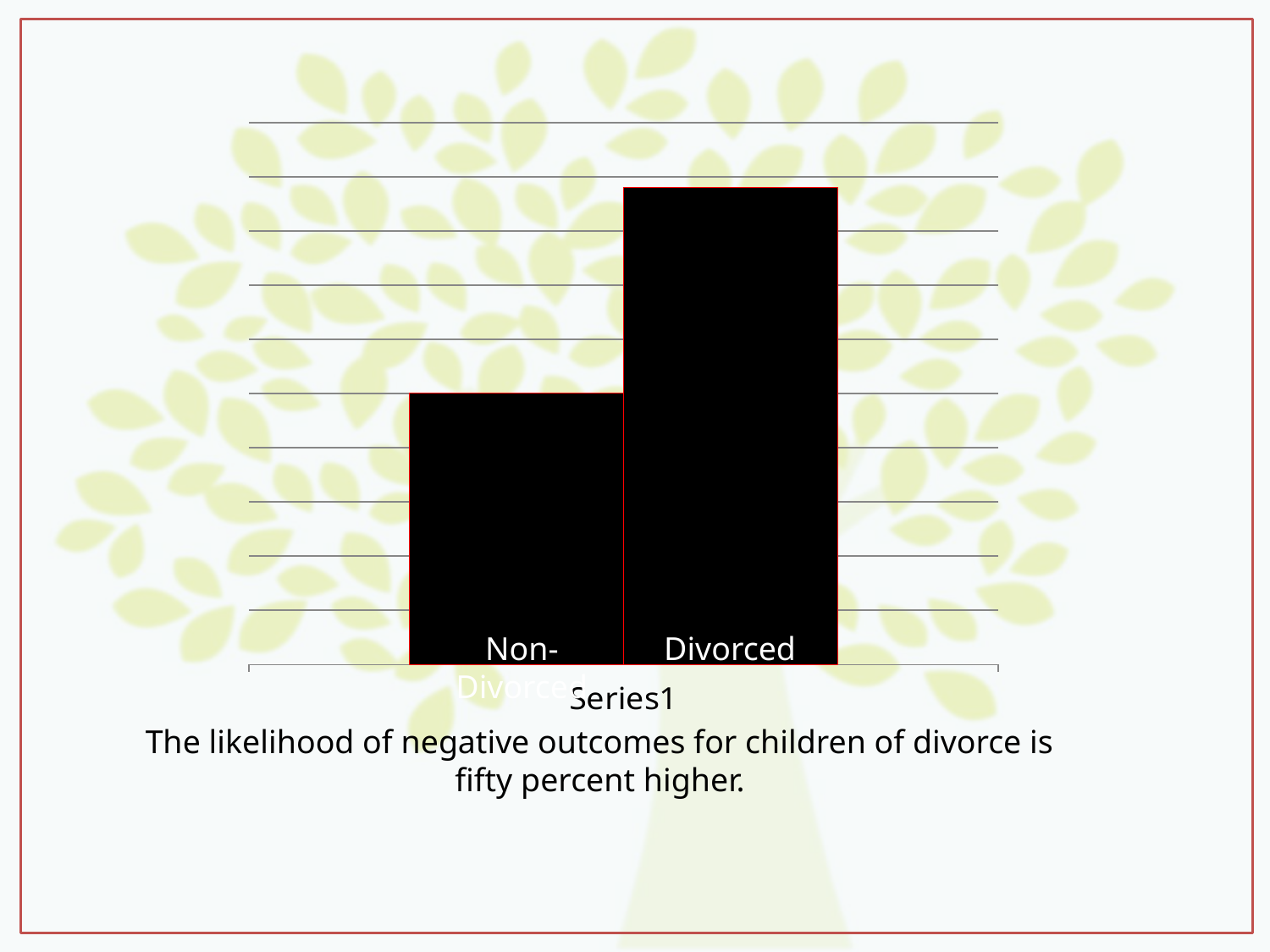
Which bar is taller, Non-Divorced or Divorced? Divorced What kind of chart is shown on the slide? bar chart What label appears beneath the category axis of the chart? Series1 Which category has the lowest bar in the chart? Non-Divorced Which category has the highest bar in the chart? Divorced What colour are the bars in the chart? black How many bars are plotted in the chart? 2 Is the bar for Non-Divorced taller or shorter than the bar for Divorced? shorter